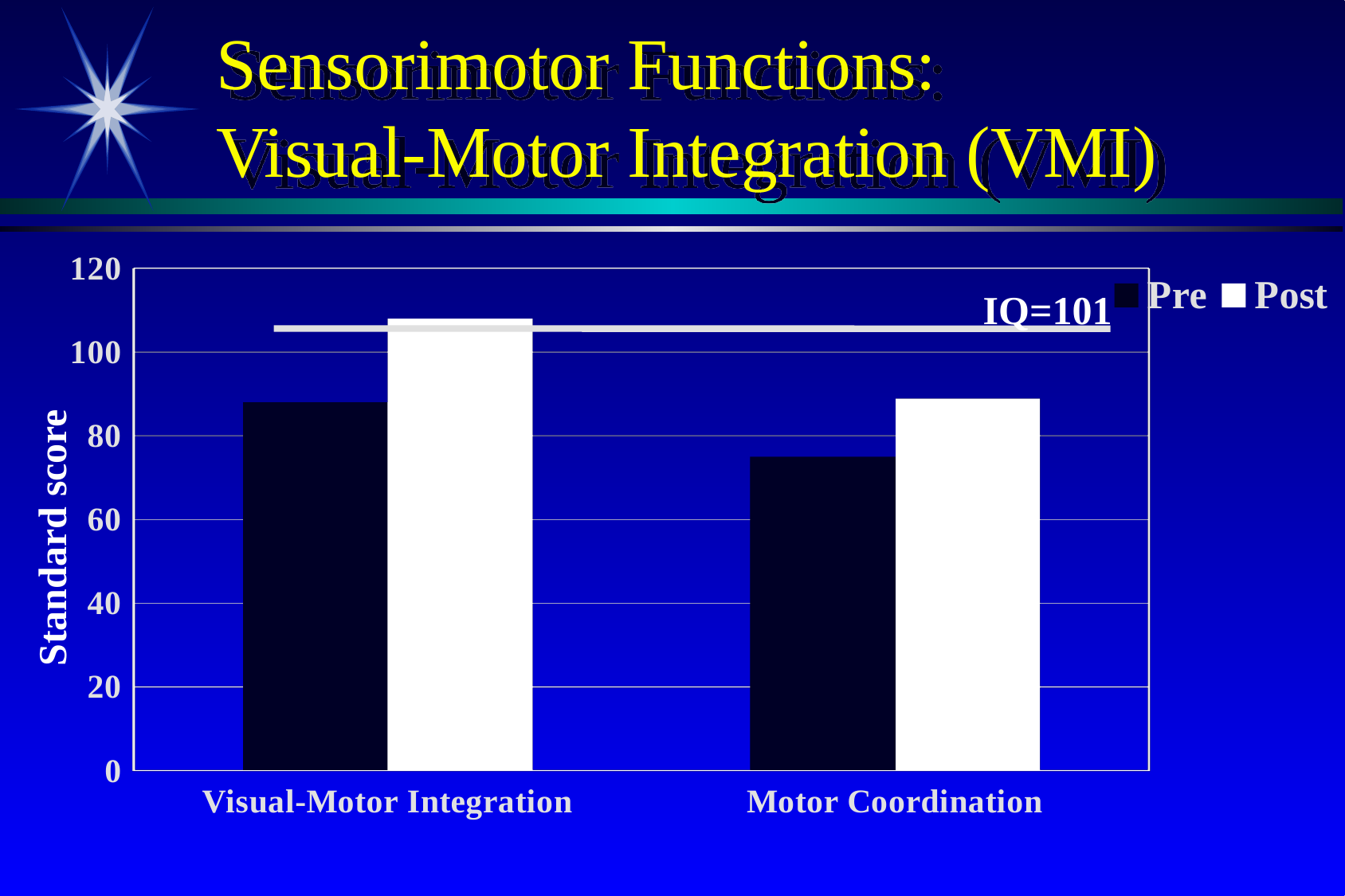
How many series does the chart's legend list? 2 Is the Post value for Visual-Motor Integration greater or less than 100? greater Is the Pre value for Motor Coordination greater or less than 80? less What kind of chart is shown on the slide? bar chart Is the Pre value for Visual-Motor Integration greater or less than 100? less Which series are listed in the chart's legend? Pre and Post Which bar in the chart is the highest? Post for Visual-Motor Integration For Visual-Motor Integration, which is larger, the Pre value or the Post value? Post How many categories are shown on the x axis of the chart? 2 Which bar in the chart is the lowest? Pre for Motor Coordination What is the label of the chart's y axis? Standard score